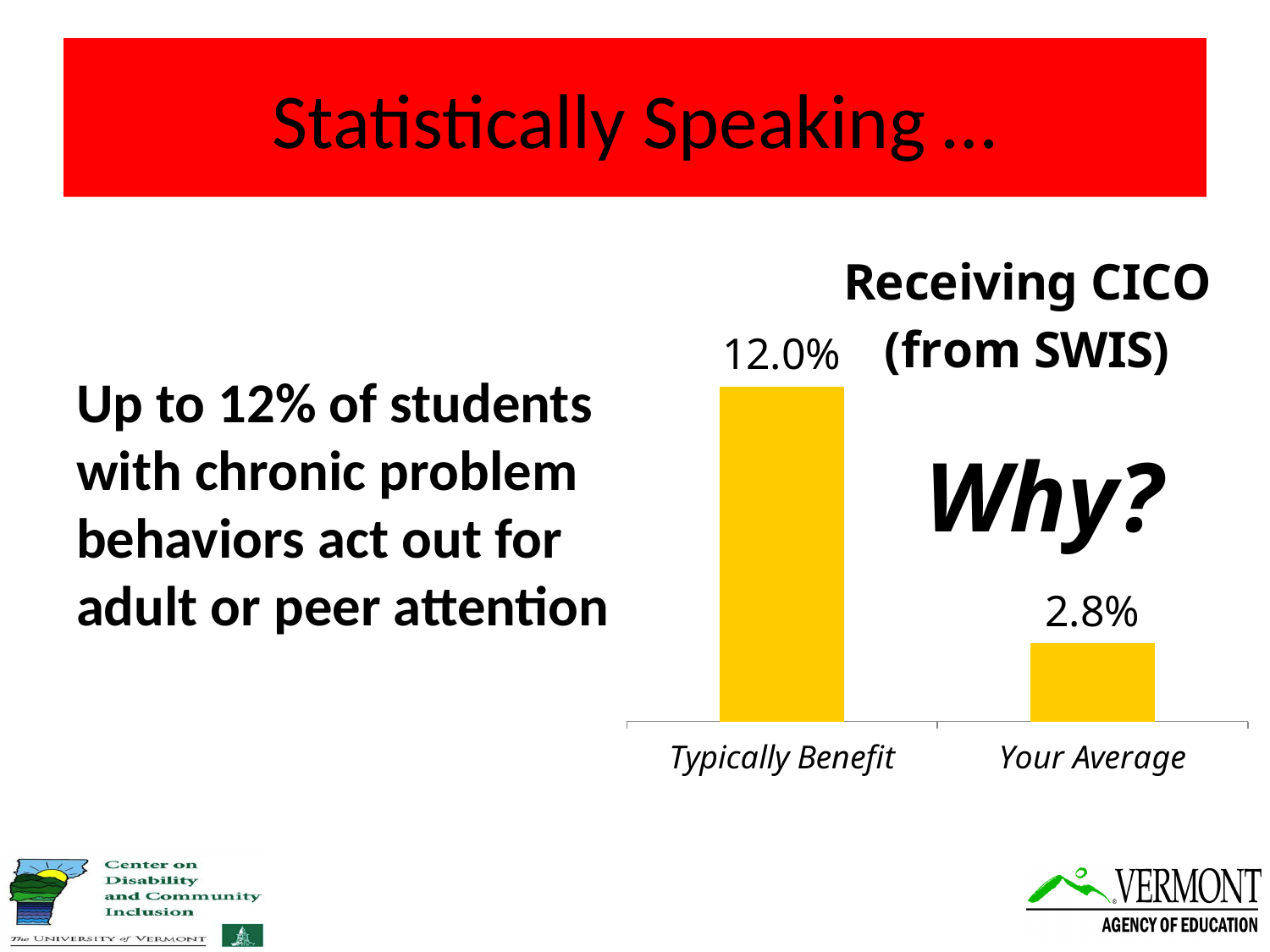
Do the values rise or fall from Typically Benefit to Your Average? fall What is the difference between the values for Typically Benefit and Your Average? 9.2% What kind of chart is shown on the slide? bar chart What is the value for Your Average? 2.8% Which is larger, the value for Typically Benefit or the value for Your Average? Typically Benefit What is the title of the chart? Receiving CICO (from SWIS) Which category has the highest value? Typically Benefit What colour are the bars in the chart? yellow How many categories are shown in the chart? 2 What is the value for Typically Benefit? 12.0% Which category has the lowest value? Your Average